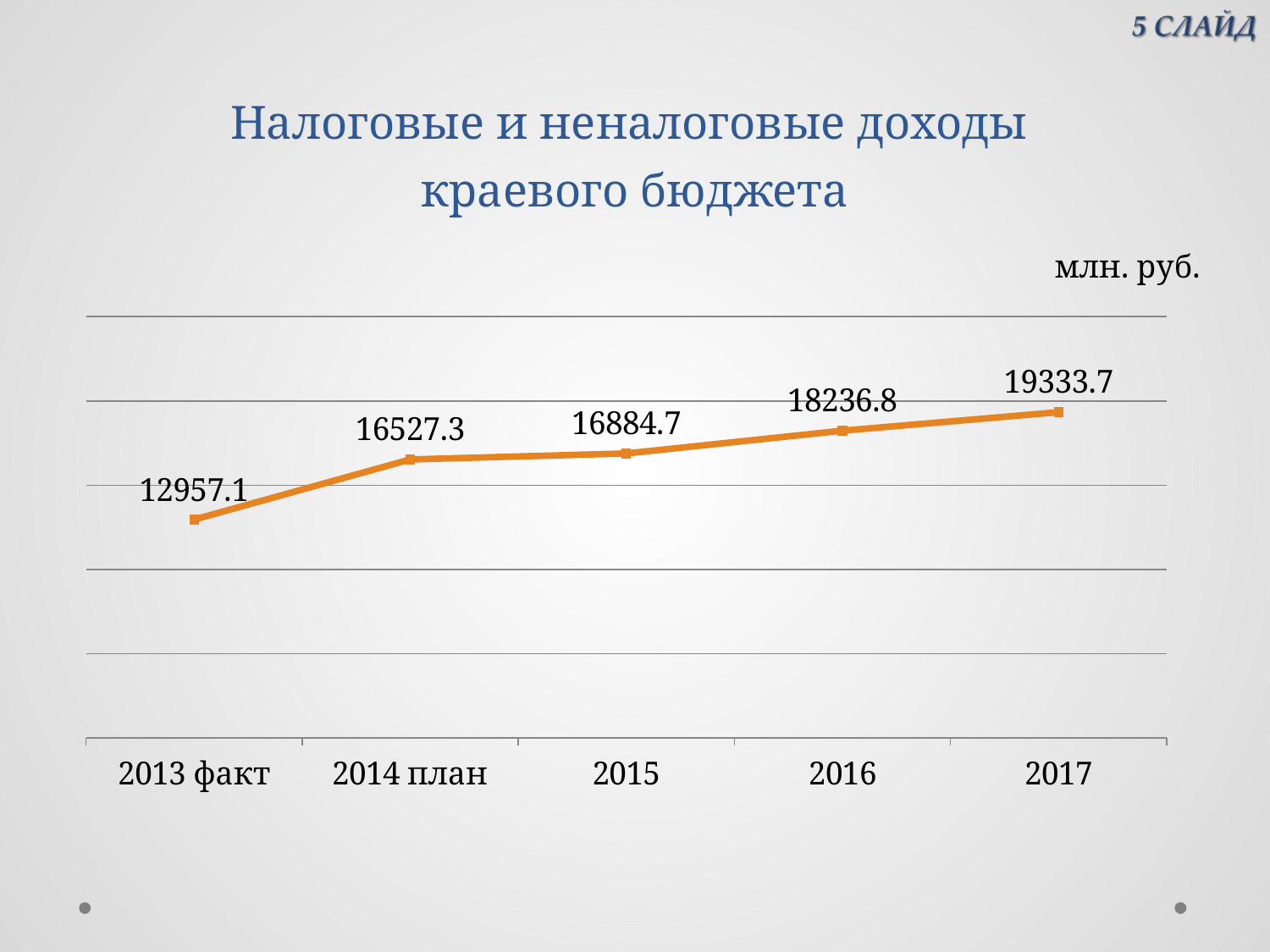
How many data points are plotted on the chart? 5 What kind of chart is shown on the slide? line chart Which year has the highest value? 2017 What is the value for 2017? 19333.7 What is the value for 2015? 16884.7 What is the value for 2014 план? 16527.3 What is the difference between the values for 2016 and 2015? 1352.1 What is the value for 2016? 18236.8 What is the difference between the values for 2017 and 2013 факт? 6376.6 Which is larger, the value for 2014 план or the value for 2015? 2015 What is the value for 2013 факт? 12957.1 Which year has the lowest value? 2013 факт